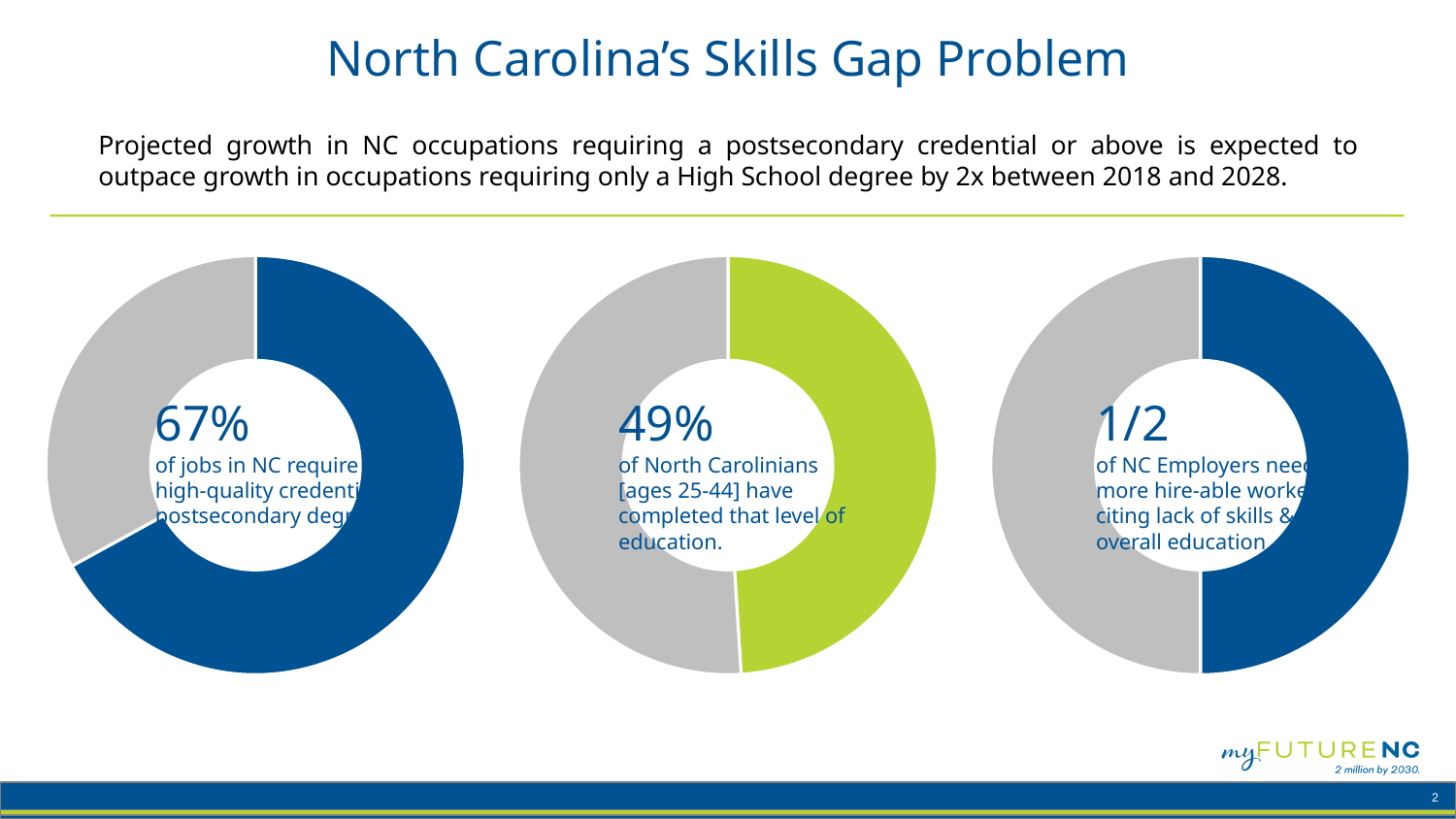
In the right donut chart, what share of the ring is grey? 1/2 In the left donut chart, what share of the ring is grey (not part of the 67%)? 33% In the left donut chart, which segment is larger, the blue one or the grey one? blue Is the highlighted share in the middle donut chart greater or less than 50%? less What kind of chart is used for the three figures on the slide? donut chart How many donut charts are shown on the slide? 3 In the right donut chart, what fraction of NC employers need more hire-able workers? 1/2 In the middle donut chart, what percentage of North Carolinians ages 25-44 have completed that level of education? 49% In the left donut chart, what percentage of jobs in NC require a high-quality credential or postsecondary degree? 67% What colour is the highlighted segment in the middle donut chart? green Which is larger: the 67% highlighted in the left donut chart or the 49% highlighted in the middle donut chart? 67% (left chart) What is the title of the slide containing the three donut charts? North Carolina's Skills Gap Problem